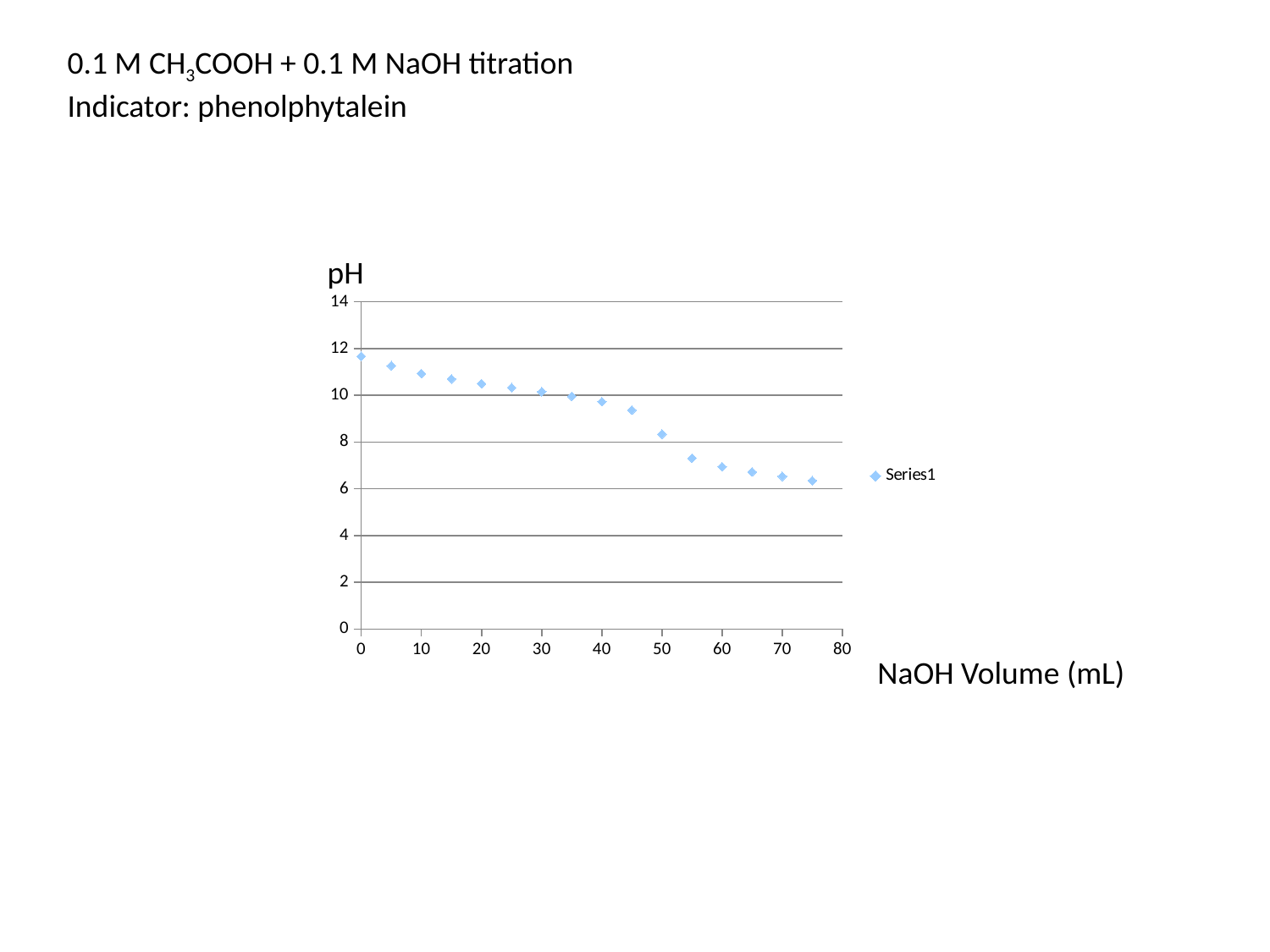
Which has the higher pH: 10 mL NaOH or 60 mL NaOH? 10 mL NaOH How many series does the legend list? 1 At which NaOH volume is the pH highest? 0 mL What is the label of the x axis? NaOH Volume (mL) Do the pH values rise or fall as the NaOH volume increases along the x axis? fall Is the pH value at 55 mL NaOH greater or less than 8? less Is the pH value at 0 mL NaOH greater or less than 10? greater At which NaOH volume is the pH lowest? 75 mL Is the pH value at 45 mL NaOH greater or less than 8? greater What kind of chart is shown on the slide? scatter chart How many data points are plotted on the chart? 16